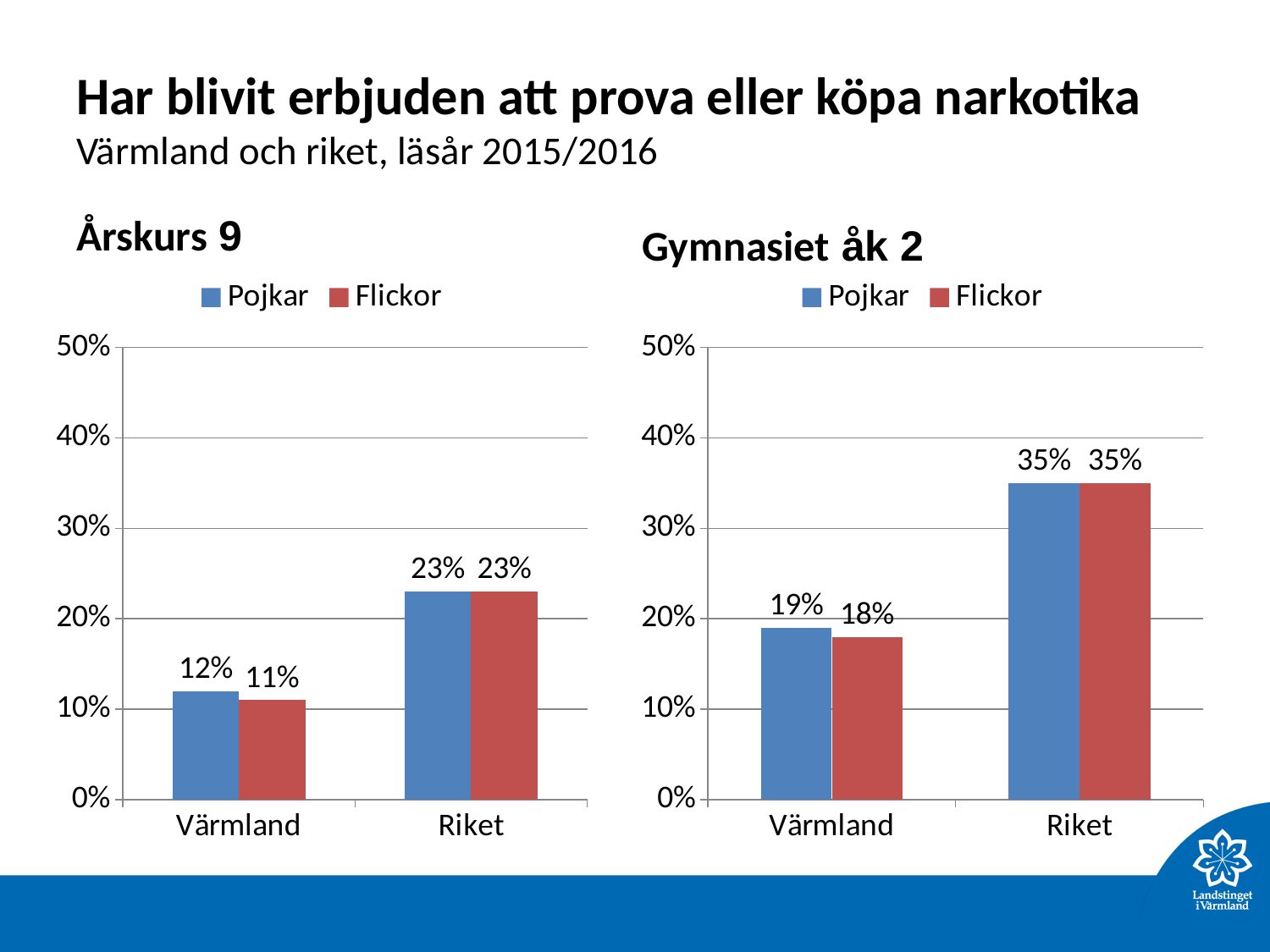
In the Årskurs 9 chart, what is the value for Pojkar in Värmland? 12% In the Årskurs 9 chart, what is the difference between Flickor in Riket and Flickor in Värmland? 12% In the Gymnasiet åk 2 chart, what is the difference between Pojkar in Riket and Pojkar in Värmland? 16% In the Gymnasiet åk 2 chart, what is the value for Flickor in Värmland? 18% What kind of chart is the Gymnasiet åk 2 chart? Bar chart In the Årskurs 9 chart, is the value for Flickor in Värmland greater or less than 20%? less In the Gymnasiet åk 2 chart, is the value for Pojkar in Riket greater or less than 30%? greater In the Årskurs 9 chart, what is the value for Flickor in Riket? 23% In the Årskurs 9 chart, which category has the higher value for Pojkar, Värmland or Riket? Riket How many series does the legend of the Gymnasiet åk 2 chart list? 2 How many categories are shown on the x axis of the Årskurs 9 chart? 2 In the Gymnasiet åk 2 chart, what is the value for Pojkar in Riket? 35%